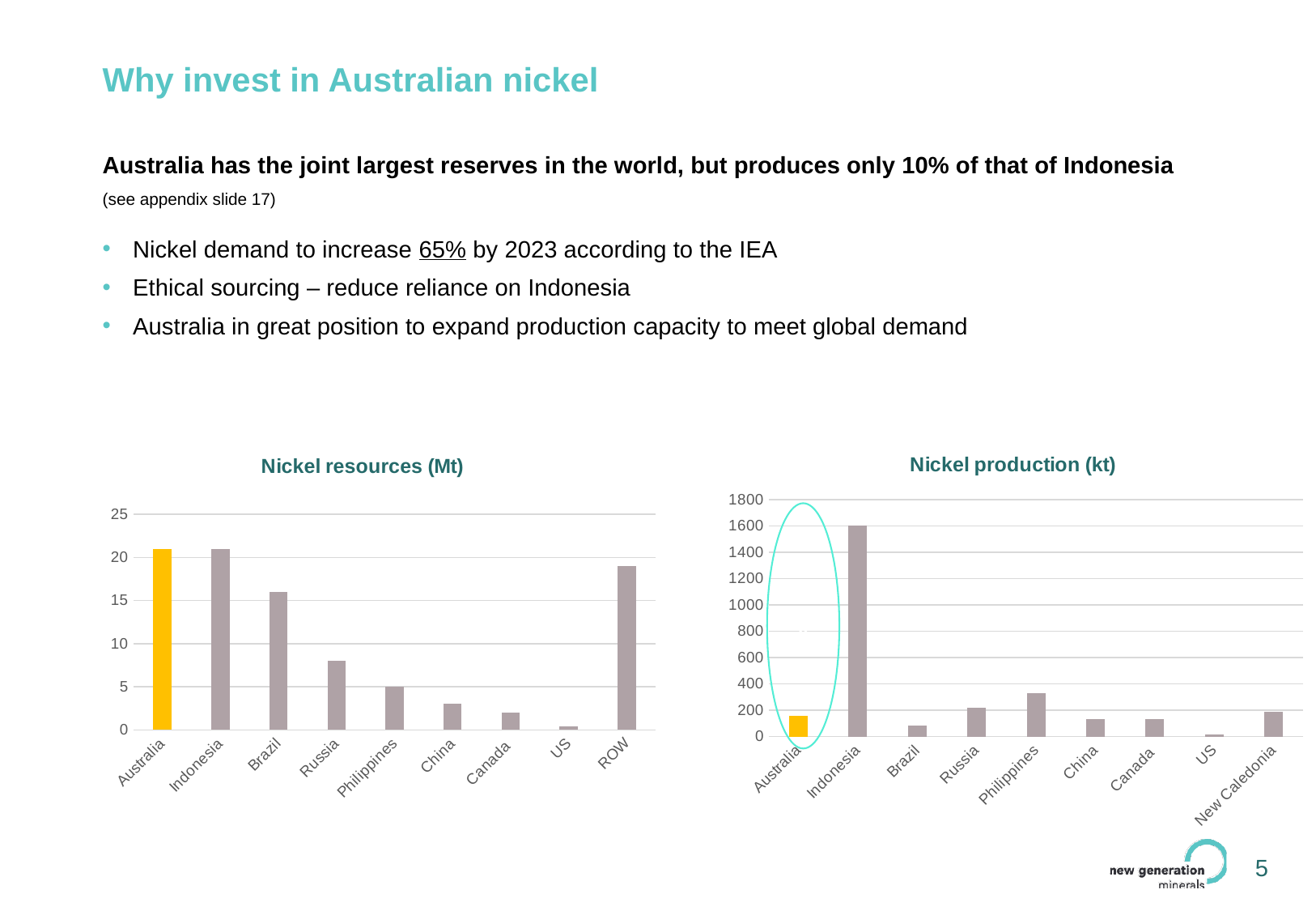
How many countries are shown in the 'Nickel production (kt)' chart? 9 What kind of chart is the 'Nickel resources (Mt)' chart? bar chart In the 'Nickel production (kt)' chart, is the value for Philippines greater or less than 400? less In the 'Nickel production (kt)' chart, which country has the lowest production? US In the 'Nickel production (kt)' chart, which country has the highest production? Indonesia In the 'Nickel production (kt)' chart, what is the production value for Indonesia? 1600 In the 'Nickel resources (Mt)' chart, is the value for Russia greater or less than 10? less In the 'Nickel resources (Mt)' chart, which is larger, Brazil or ROW? ROW How many countries/categories are shown in the 'Nickel resources (Mt)' chart? 9 In the 'Nickel resources (Mt)' chart, is the value for Brazil greater or less than 15? greater In the 'Nickel production (kt)' chart, which bar is highlighted in yellow? Australia In the 'Nickel resources (Mt)' chart, which country has the lowest value? US